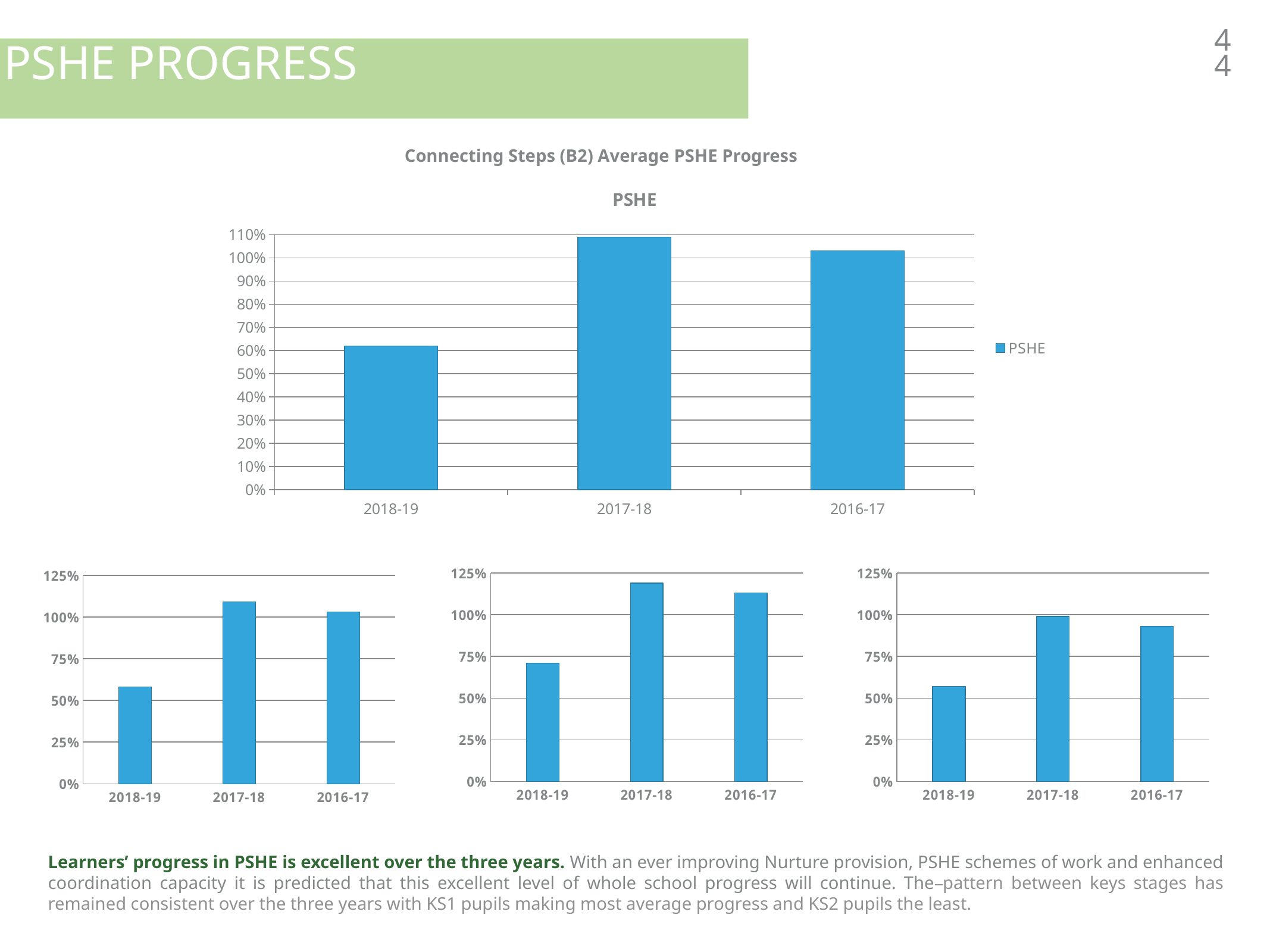
In the top chart titled "PSHE", which year has the highest value? 2017-18 In the bottom-right chart, is the value for 2018-19 greater or less than 75%? less In the top chart titled "PSHE", which year has the lowest value? 2018-19 In the top chart titled "PSHE", which is larger, the value for 2017-18 or the value for 2016-17? 2017-18 In the top chart titled "PSHE", is the value for 2018-19 greater or less than 50%? greater How many categories are shown on the x axis of the top chart titled "PSHE"? 3 In the top chart titled "PSHE", is the value for 2017-18 greater or less than 100%? greater What is the legend entry shown on the top chart? PSHE How many series does the legend of the top chart titled "PSHE" list? 1 In the bottom-middle chart, which year has the highest value? 2017-18 In the bottom-left chart, which year has the lowest value? 2018-19 What kind of chart is the top chart titled "PSHE"? bar chart